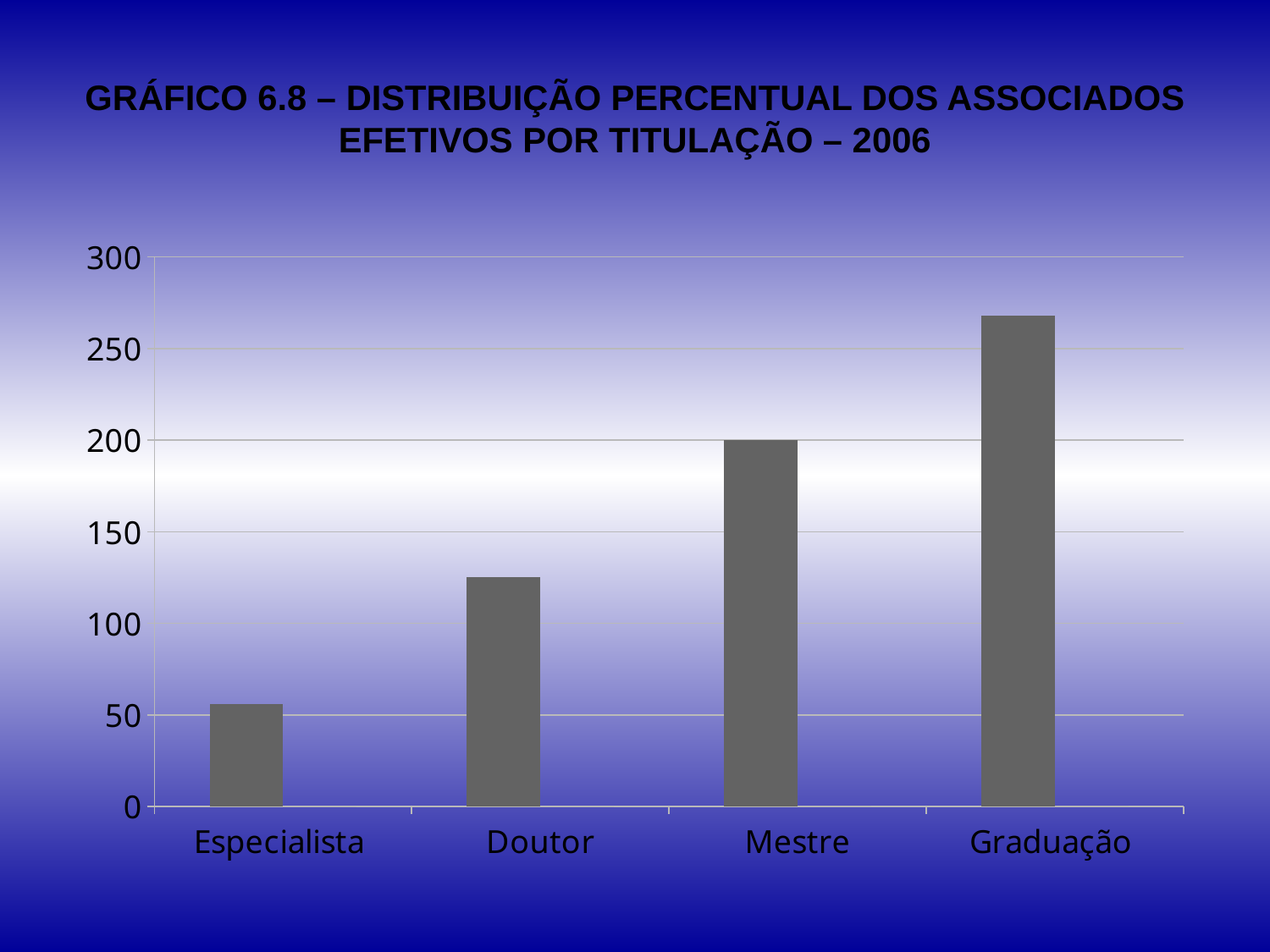
Which category has the highest value? Graduação Which is larger, the value for Graduação or the value for Especialista? Graduação Is the value for Graduação greater or less than 250? greater Which category has the lowest value? Especialista Is the value for Especialista greater or less than 100? less Is the value for Doutor greater or less than 150? less What kind of chart is shown on the slide? bar chart Which is larger, the value for Mestre or the value for Doutor? Mestre What year is given in the chart title? 2006 Do the values rise or fall from left to right along the x axis? rise How many categories are shown on the x axis? 4